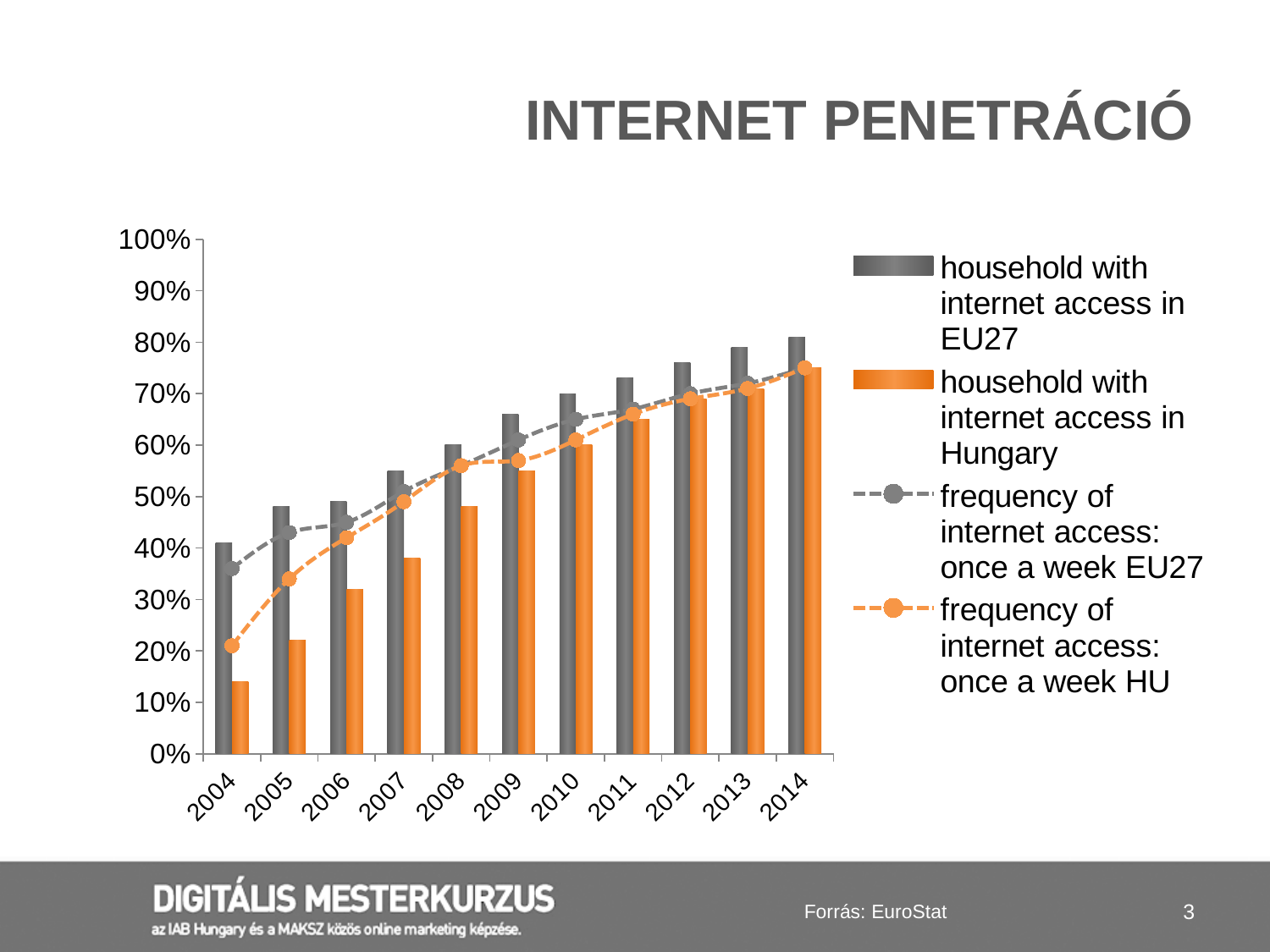
What kind of chart is shown on the slide? A combined bar and line chart Which colour represents the Hungary series in the chart? Orange Is the value for 'household with internet access in Hungary' in 2004 greater or less than 20%? less How many years are shown on the x axis of the chart? 11 In 2004, which is larger: household internet access in EU27 or in Hungary? EU27 How many series does the chart's legend list? 4 In which year is the 'household with internet access in EU27' bar the highest? 2014 Is the value for 'household with internet access in Hungary' in 2007 greater or less than 40%? less Is the value for 'household with internet access in EU27' in 2005 greater or less than 50%? less In which year is the 'household with internet access in Hungary' bar the lowest? 2004 Do the 'household with internet access in Hungary' values rise or fall from 2004 to 2014? rise